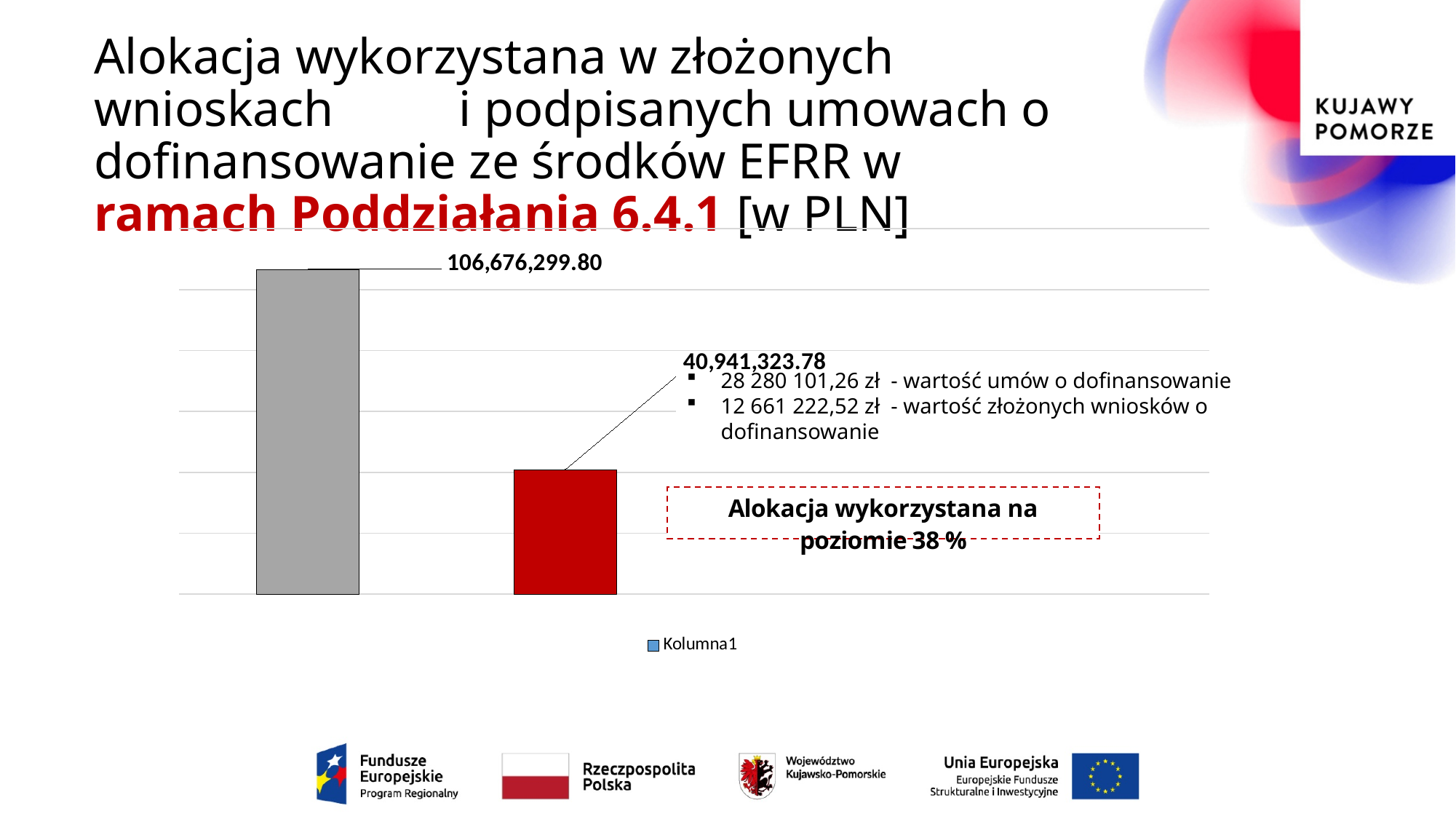
According to the dashed text box next to the chart, at what level was the allocation used? 38 % What value is printed on the red (right) bar of the chart? 40,941,323.78 How many bars are plotted in the chart? 2 What is the name of the series shown in the chart legend? Kolumna1 What value is printed on the grey (left) bar of the chart? 106,676,299.80 Which bar has the lower value, the grey bar or the red bar? the red bar How many series does the chart legend list? 1 Which bar has the higher value, the grey bar or the red bar? the grey bar Is the value of the red bar larger or smaller than the value of the grey bar? smaller What is the difference between the grey bar's value and the red bar's value? 65,734,976.02 What kind of chart is shown on the slide? bar chart